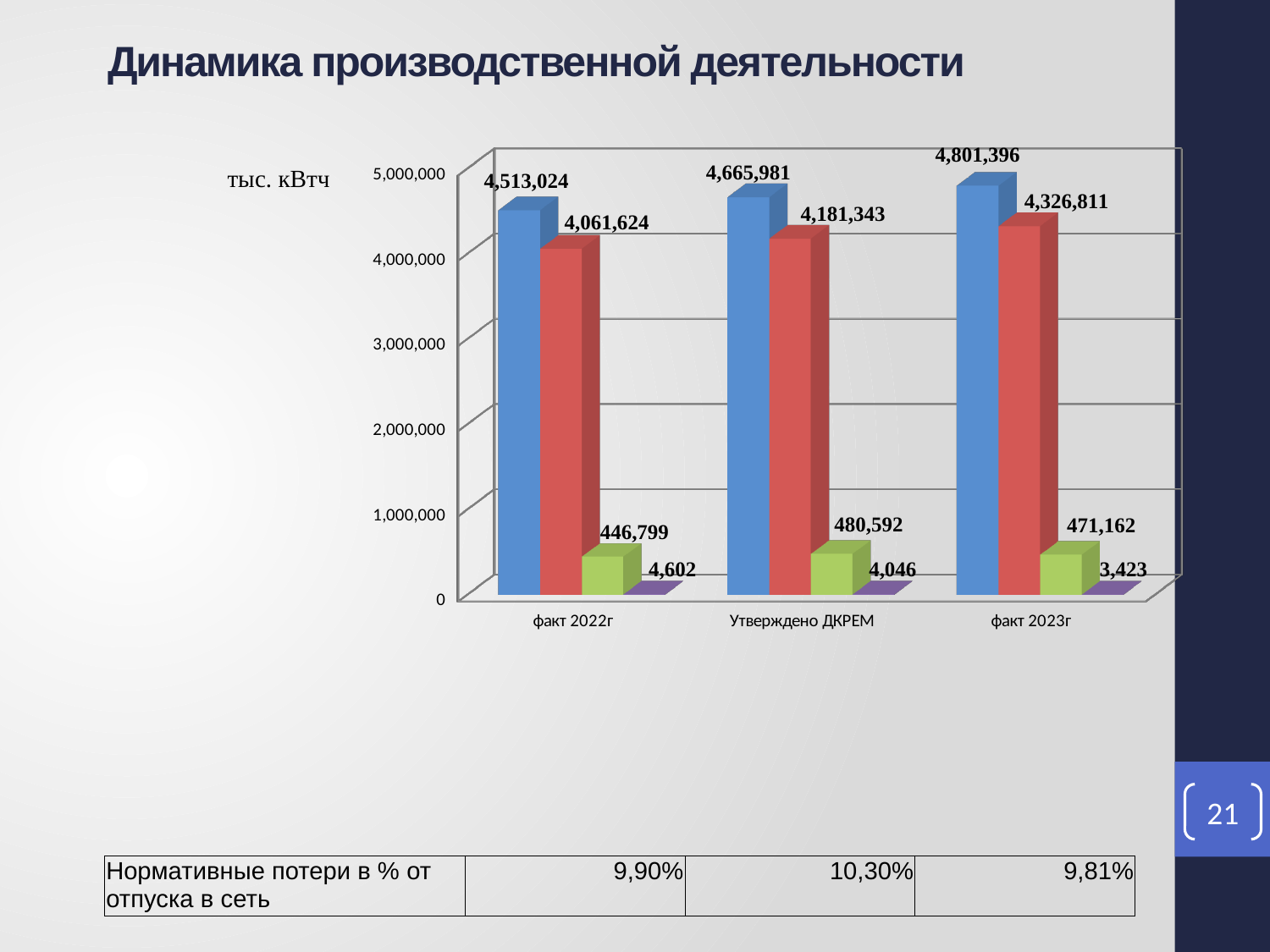
What is the difference between the blue bar values for факт 2023г and факт 2022г? 288,372 What is the value of the red bar for Утверждено ДКРЕМ? 4,181,343 What is the value of the blue bar for факт 2023г? 4,801,396 What kind of chart is shown on the slide? bar chart Which category has the highest blue bar? факт 2023г Which category has the lowest purple bar value? факт 2023г Which is larger: the green bar for Утверждено ДКРЕМ or the green bar for факт 2023г? Утверждено ДКРЕМ How many categories are shown on the x axis? 3 What is the value of the purple bar for факт 2023г? 3,423 Is the red bar for факт 2022г greater or less than 4,000,000? greater What is the value of the green bar for факт 2022г? 446,799 What unit label is shown next to the chart's vertical axis? тыс. кВтч